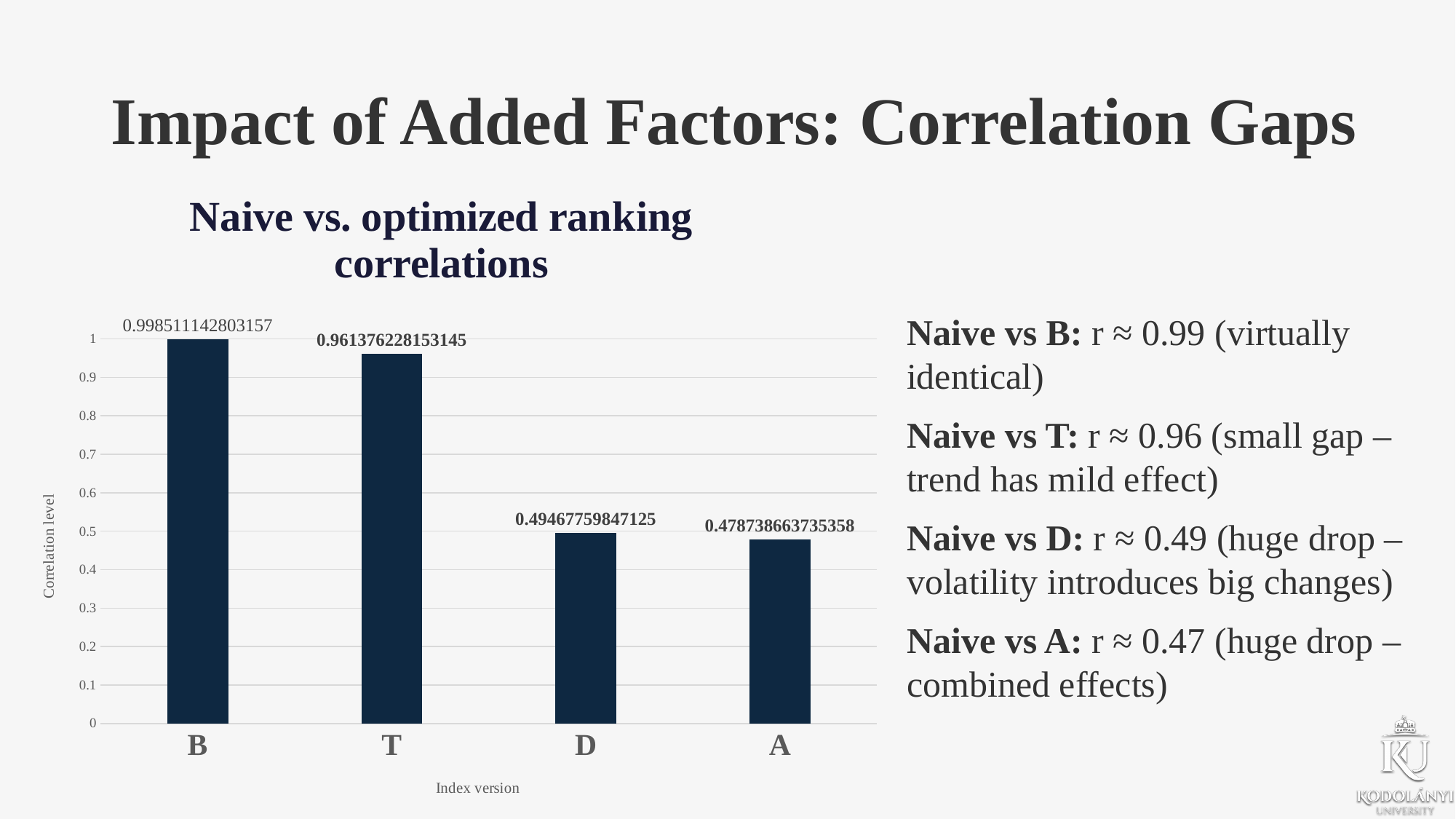
What is the correlation value for index version B? 0.998511142803157 Which index version has the lowest correlation level? A How many index versions are shown on the x axis? 4 What kind of chart is shown on the slide? bar chart Is the correlation value for D greater or less than 0.5? less What is the correlation value for index version T? 0.961376228153145 Which index version has the highest correlation level? B What is the correlation value for index version D? 0.49467759847125 What is the title of the chart? Naive vs. optimized ranking correlations What is the correlation value for index version A? 0.478738663735358 Which has a higher correlation level, T or D? T Do the correlation values rise or fall from B to A along the x axis? fall